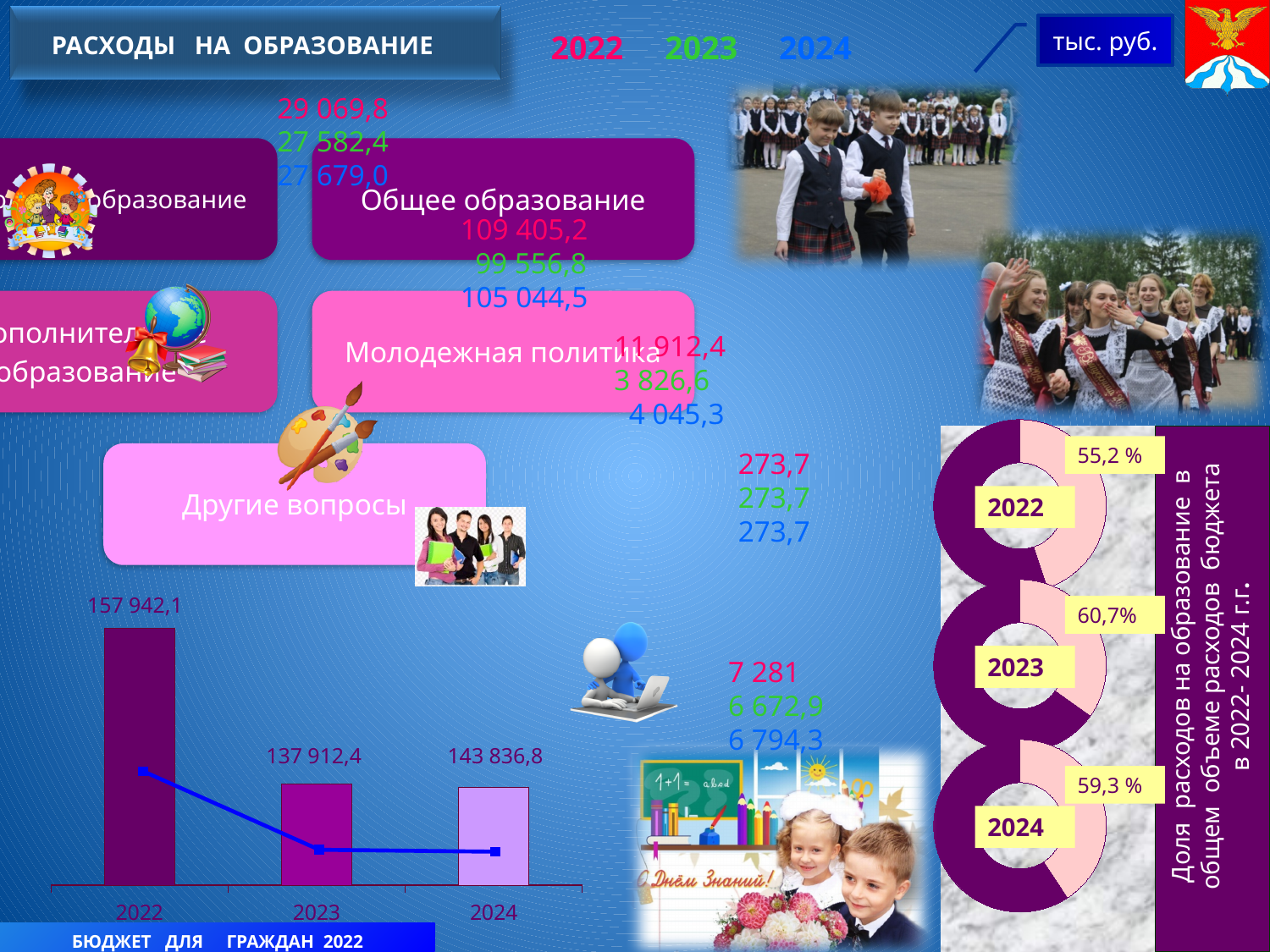
In the bar chart at the bottom left, which year has the lowest value? 2023 In the bar chart at the bottom left, which is larger: the value for 2023 or the value for 2024? 2024 In the bar chart at the bottom left, what is the value for 2023? 137 912,4 In the bar chart at the bottom left, what is the value for 2022? 157 942,1 How many bars are in the bar chart at the bottom left? 3 In the bar chart at the bottom left, what is the difference between the values for 2024 and 2023? 5 924,4 In the donut charts on the right (share of education spending in total budget spending), what is the share for 2023? 60,7% In the bar chart at the bottom left, what is the value for 2024? 143 836,8 In the donut charts on the right (share of education spending in total budget spending), which year has the lowest share? 2022 In the bar chart at the bottom left, what is the difference between the values for 2022 and 2023? 20 029,7 What kind of chart is shown at the bottom left of the slide? bar chart In the bar chart at the bottom left, which year has the highest value? 2022